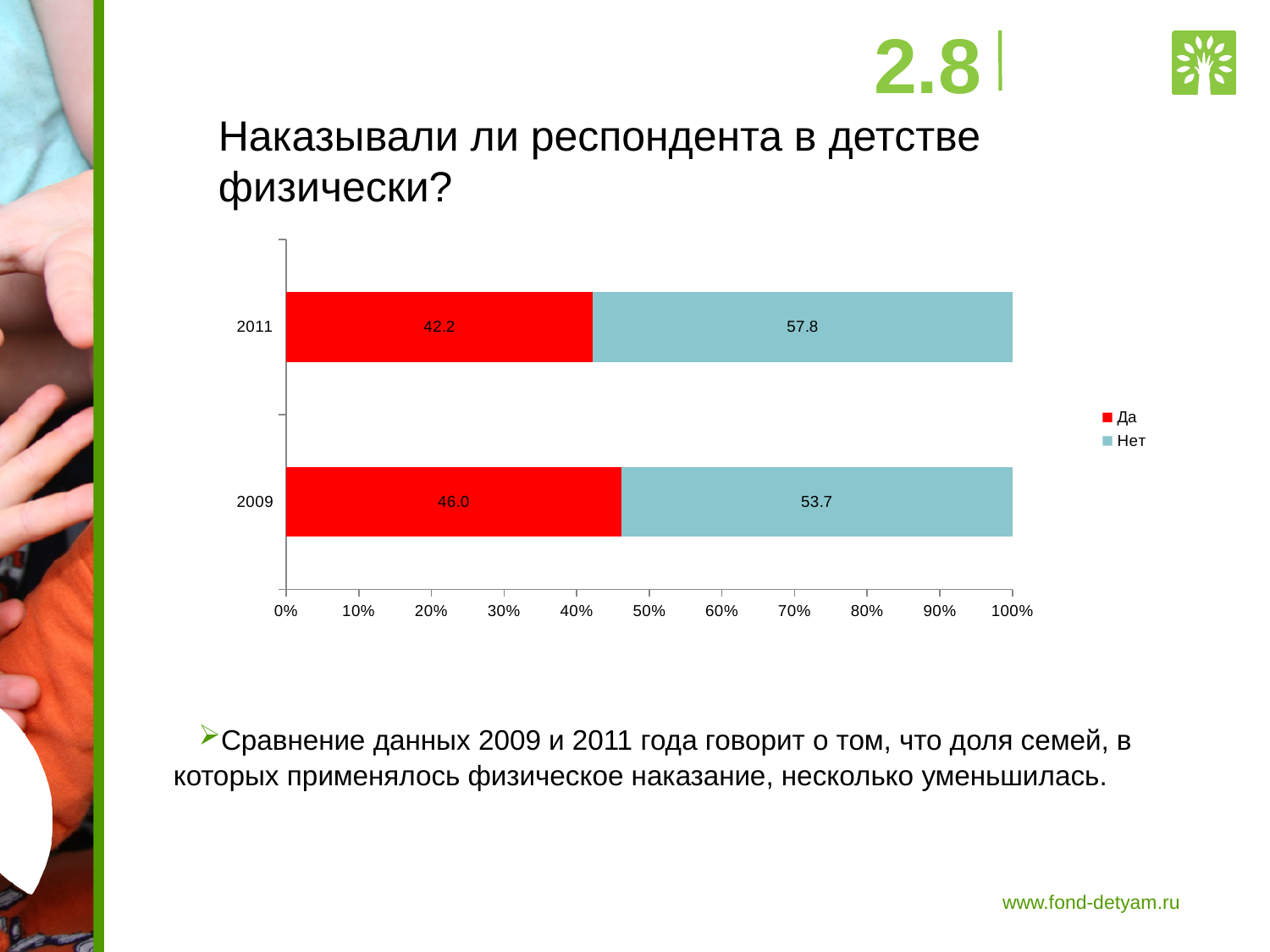
What is the value of the "Да" series for 2011? 42.2 What is the value of the "Нет" series for 2009? 53.7 How many series does the legend list? 2 What is the difference between the "Да" values for 2009 and 2011? 3.8 What is the total of the stacked bar for 2009? 99.7 Which colour represents the "Да" series in the chart? Red What is the value of the "Да" series for 2009? 46.0 What is the value of the "Нет" series for 2011? 57.8 How many categories (years) are shown on the chart? 2 What kind of chart is shown on the slide? Stacked bar chart Which year has the higher value for the "Да" series? 2009 What is the difference between the "Нет" values for 2011 and 2009? 4.1